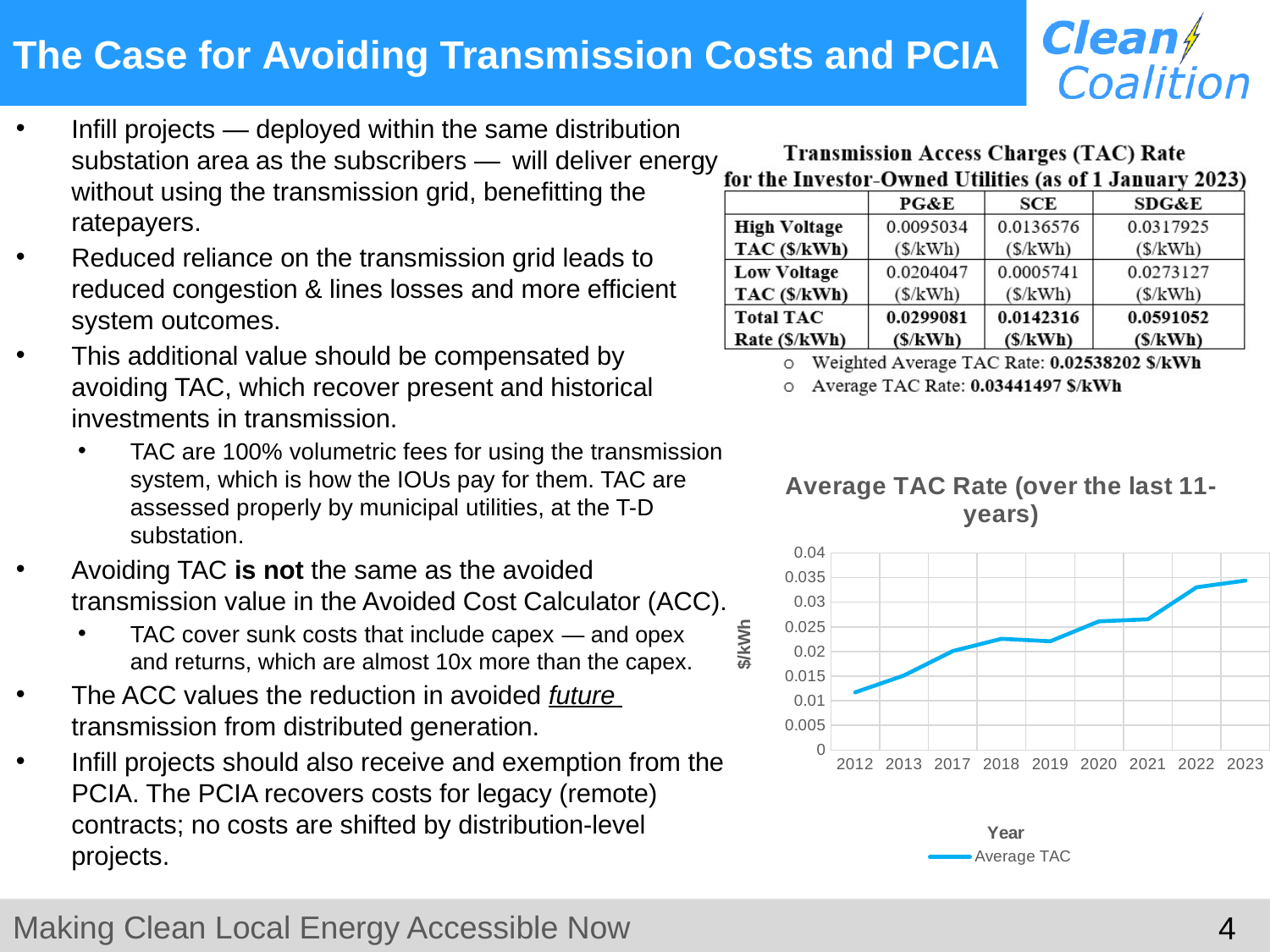
Which year has the lowest average TAC rate in the Average TAC Rate chart? 2012 Which year has the highest average TAC rate in the Average TAC Rate chart? 2023 In the Average TAC Rate chart, which year has the larger average TAC rate, 2017 or 2022? 2022 In the Average TAC Rate chart, is the value for 2012 greater or less than 0.015? less How many years are plotted on the x axis of the Average TAC Rate chart? 9 What kind of chart is the 'Average TAC Rate (over the last 11-years)' chart? line chart What is the y-axis label of the Average TAC Rate chart? $/kWh In the Average TAC Rate chart, is the value for 2017 greater or less than 0.015? greater What is the legend entry shown below the Average TAC Rate chart? Average TAC In the Average TAC Rate chart, is the value for 2023 greater or less than 0.03? greater How many series does the legend of the Average TAC Rate chart list? 1 In the Average TAC Rate chart, does the average TAC rate generally rise or fall from 2012 to 2023? rise